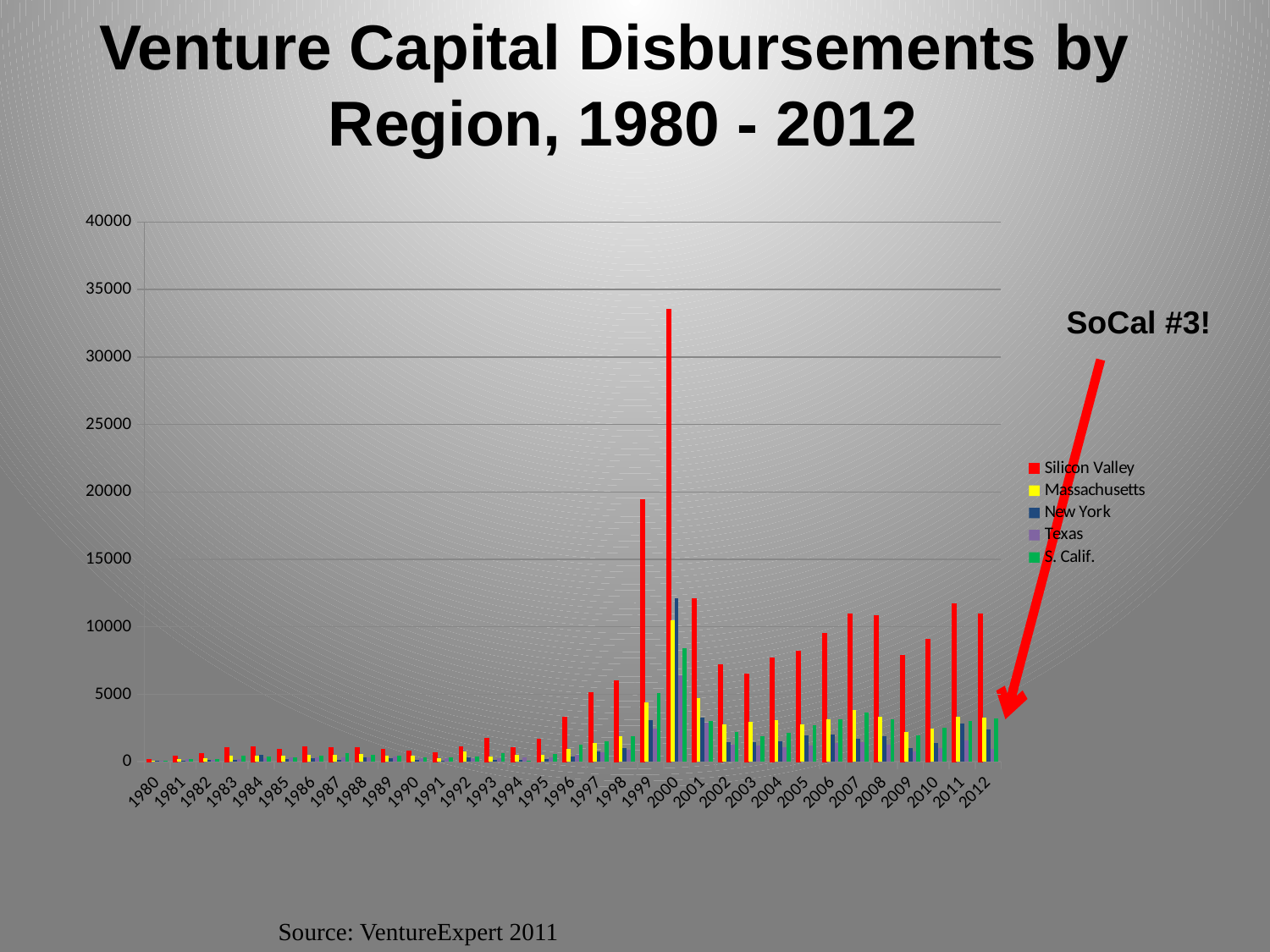
How many series does the legend list? 5 Which region has the tallest bar in 2000? Silicon Valley Which region does the red series in the legend represent? Silicon Valley Is the value for New York in 2000 greater or less than 10000? greater Which is larger for Silicon Valley: the value in 1999 or the value in 2000? 2000 Is the value for S. Calif. in 2000 greater or less than 5000? greater How many years are shown along the x axis? 33 Is the value for Silicon Valley in 2000 greater or less than 30000? greater What kind of chart is shown on the slide? bar chart In which year is the Silicon Valley bar the highest? 2000 Which is larger for Silicon Valley: the value in 2011 or the value in 2012? 2011